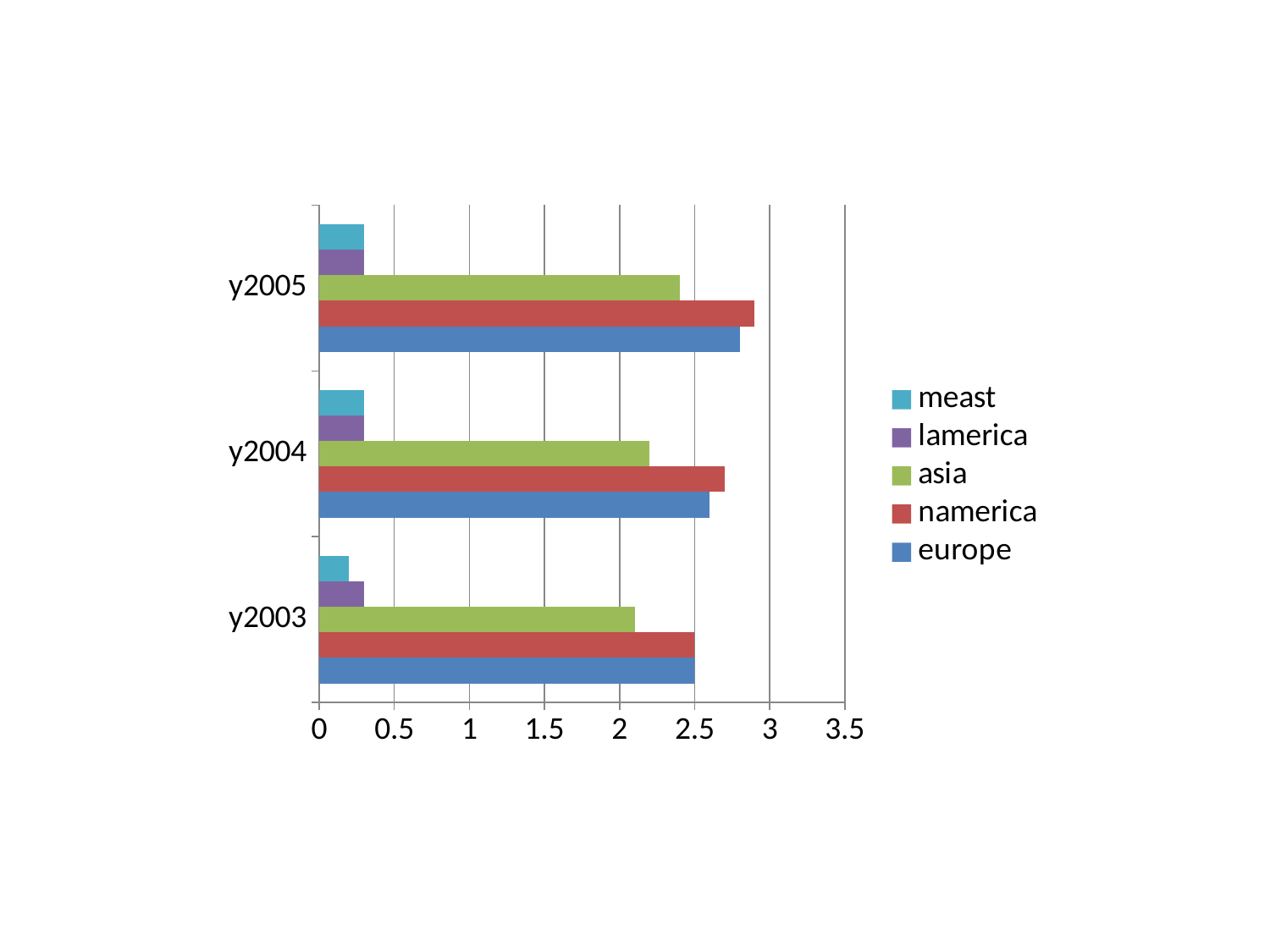
Does the value for asia rise or fall from y2003 to y2005? rise In y2005, which is larger, the value for namerica or the value for asia? namerica What is the value for europe in y2003? 2.5 What kind of chart is shown on the slide? bar chart In which category does asia have its highest value? y2005 Is the value for meast in y2003 greater or less than 0.5? less How many categories are shown on the vertical axis of the chart? 3 How many series does the chart's legend list? 5 Is the value for asia in y2004 greater or less than 2? greater Is the value for namerica in y2004 greater or less than 3? less Which colour represents the asia series in the legend? green